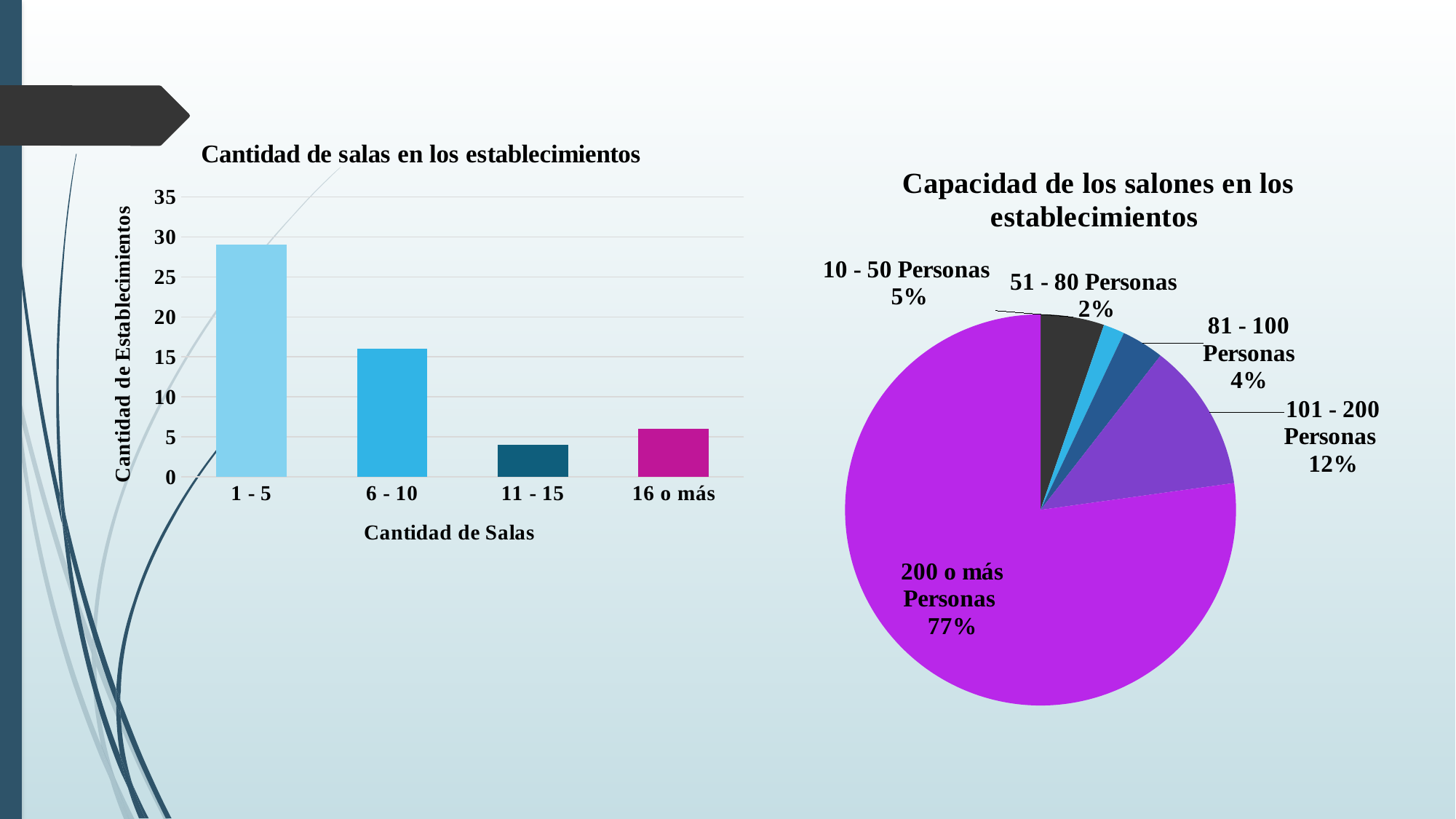
In the chart 'Cantidad de salas en los establecimientos', is the value for '11 - 15' greater or less than 5? less In the chart 'Cantidad de salas en los establecimientos', which category has the lowest value? 11 - 15 In the chart 'Cantidad de salas en los establecimientos', which is larger, the value for '6 - 10' or the value for '16 o más'? 6 - 10 What kind of chart is 'Cantidad de salas en los establecimientos'? bar chart In the chart 'Cantidad de salas en los establecimientos', is the value for '1 - 5' greater or less than 30? less In the pie chart 'Capacidad de los salones en los establecimientos', which slice is the smallest? 51 - 80 Personas What kind of chart is 'Capacidad de los salones en los establecimientos'? pie chart In the pie chart 'Capacidad de los salones en los establecimientos', what share does '101 - 200 Personas' have? 12% In the chart 'Cantidad de salas en los establecimientos', is the value for '6 - 10' greater or less than 15? greater In the chart 'Cantidad de salas en los establecimientos', which category has the highest value? 1 - 5 In the pie chart 'Capacidad de los salones en los establecimientos', what share does '200 o más Personas' have? 77% How many categories are shown in the chart 'Cantidad de salas en los establecimientos'? 4